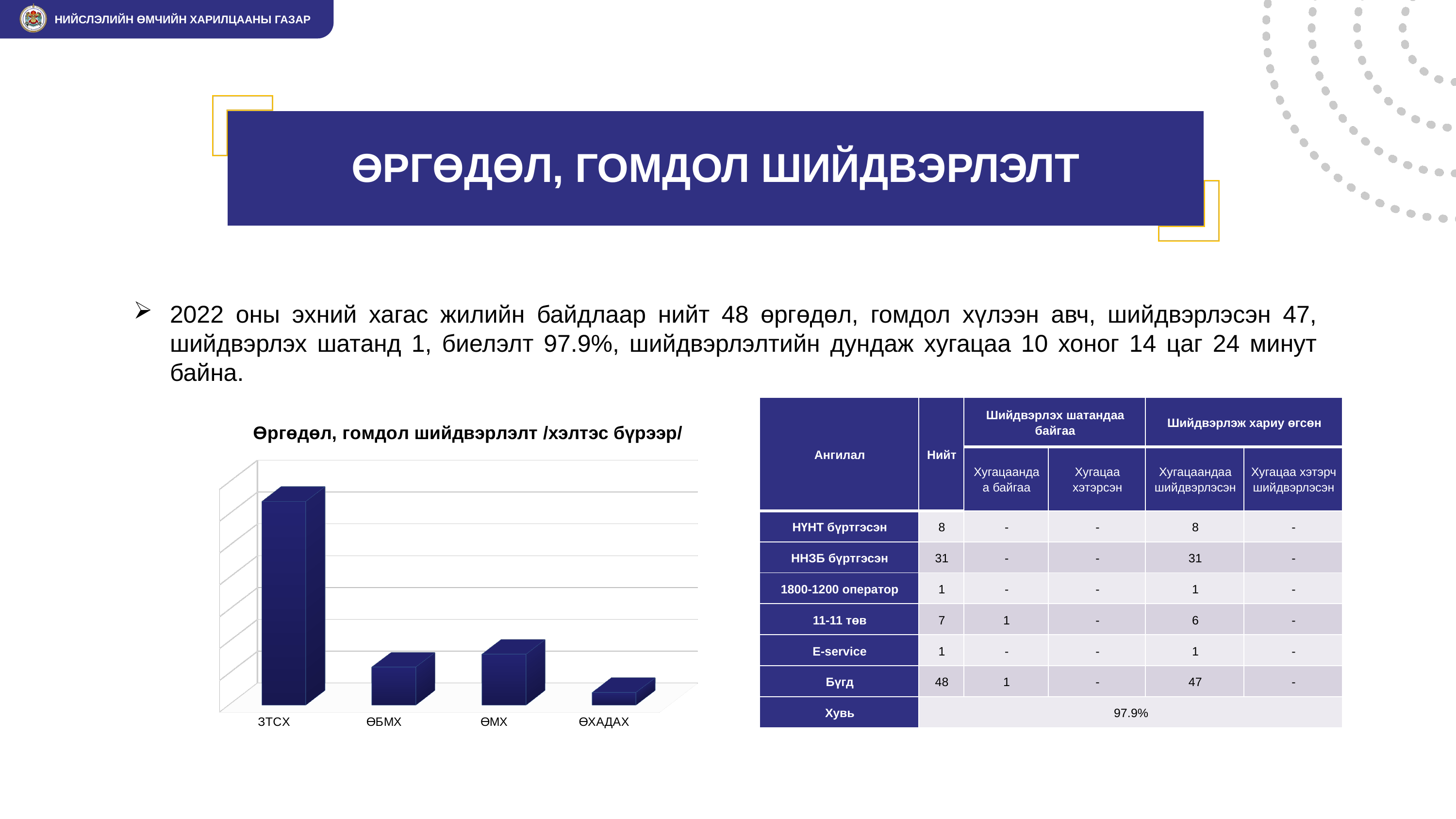
Which bar is taller, ӨМХ or ӨХАДАХ? ӨМХ Which bar is taller, ЗТСХ or ӨМХ? ЗТСХ Which category has the highest bar in the chart? ЗТСХ Which category has the lowest bar in the chart? ӨХАДАХ How many categories are shown on the x axis of the chart? 4 What is the title of the chart? Өргөдөл, гомдол шийдвэрлэлт /хэлтэс бүрээр/ Which bar is taller, ӨБМХ or ӨХАДАХ? ӨБМХ What kind of chart is shown on the slide? bar chart What is the label of the first category on the x axis of the chart? ЗТСХ